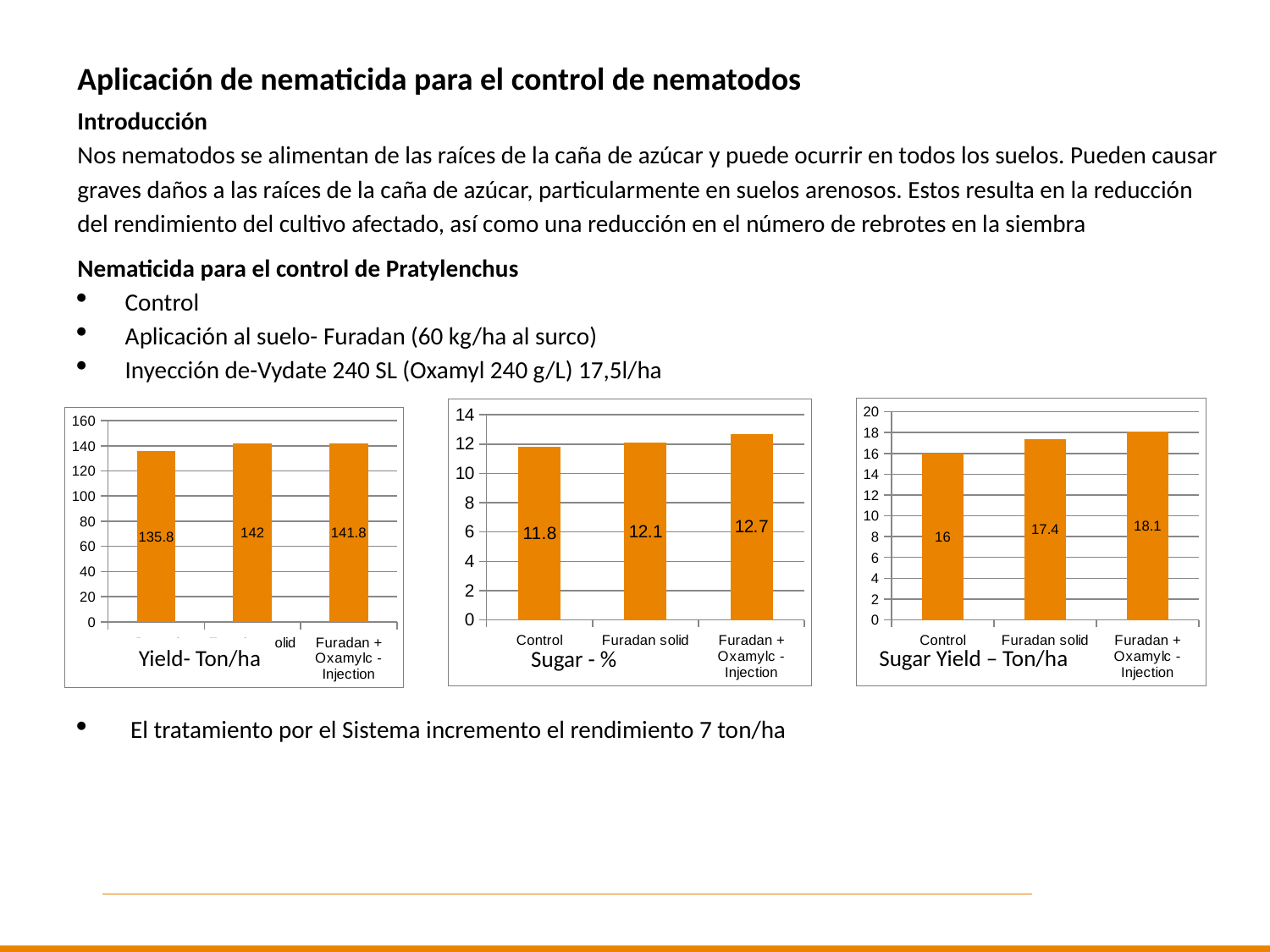
What kind of chart is the Sugar - % chart? Bar chart How many bars does the Sugar Yield – Ton/ha chart show? 3 In the Sugar - % chart, what is the value for Furadan solid? 12.1 In the Sugar Yield – Ton/ha chart, what is the value for Furadan + Oxamylc - Injection? 18.1 In the Sugar - % chart, what is the value for Control? 11.8 In the Sugar Yield – Ton/ha chart, what is the value for Control? 16 In the Yield- Ton/ha chart, what is the value for Furadan + Oxamylc - Injection? 141.8 In the Sugar - % chart, which is larger, Furadan solid or Furadan + Oxamylc - Injection? Furadan + Oxamylc - Injection In the Sugar Yield – Ton/ha chart, which category has the highest value? Furadan + Oxamylc - Injection In the Sugar - % chart, what is the value for Furadan + Oxamylc - Injection? 12.7 In the Sugar - % chart, which category has the lowest value? Control In the Sugar Yield – Ton/ha chart, what is the difference between Furadan + Oxamylc - Injection and Control? 2.1